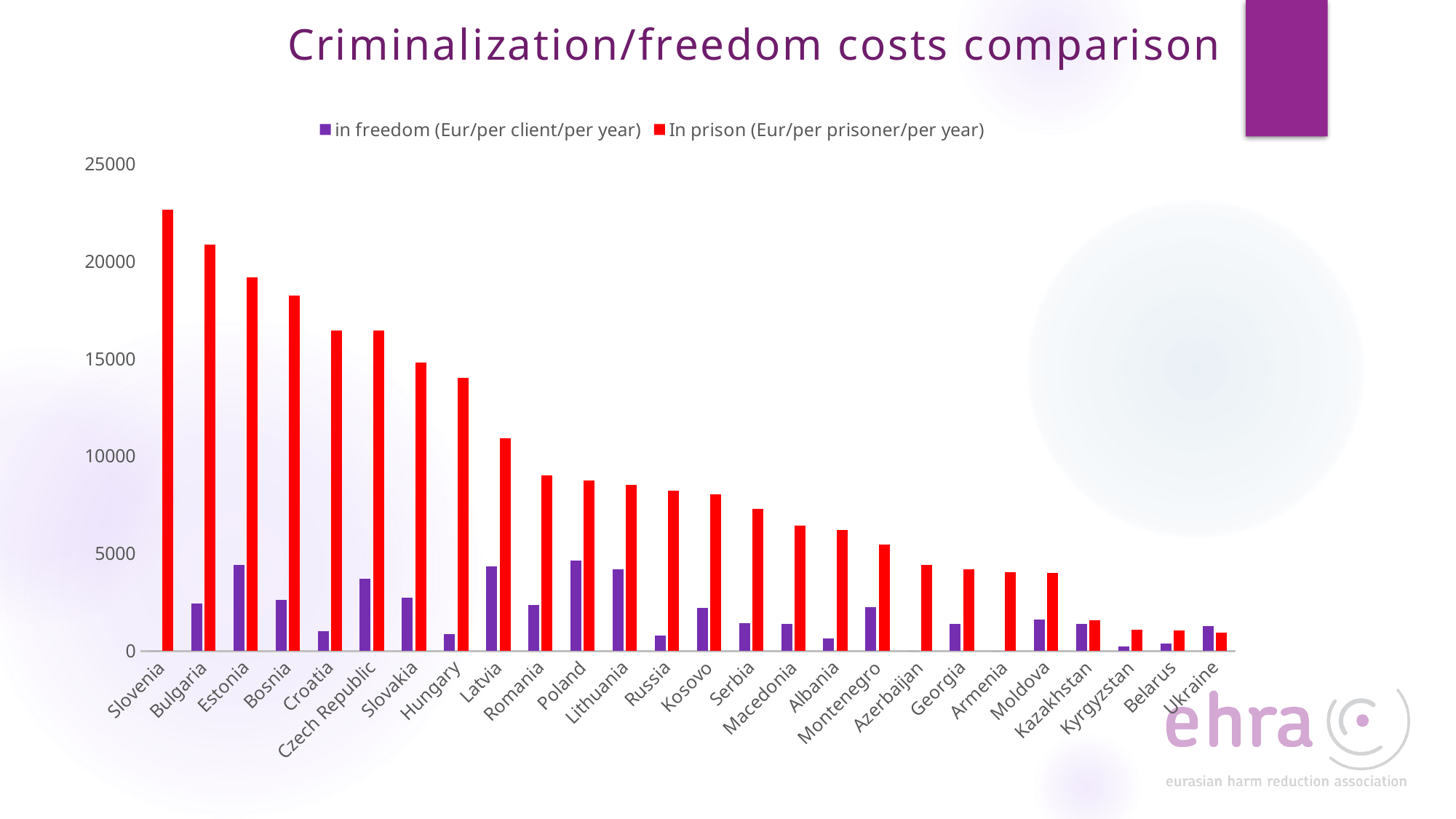
Which country has the highest 'In prison' value? Slovenia Is the 'In prison' value for Hungary greater or less than 15000? less Is the 'in freedom' value for Estonia greater or less than 5000? less How many series does the legend list? 2 Which is larger, the 'In prison' value for Slovenia or for Bulgaria? Slovenia Is the 'In prison' value for Latvia greater or less than 10000? greater How many countries are shown on the x axis? 26 What type of chart is shown on the slide? bar chart What is the title of the chart? Criminalization/freedom costs comparison Do the 'In prison' values generally rise or fall from left to right along the x axis? fall